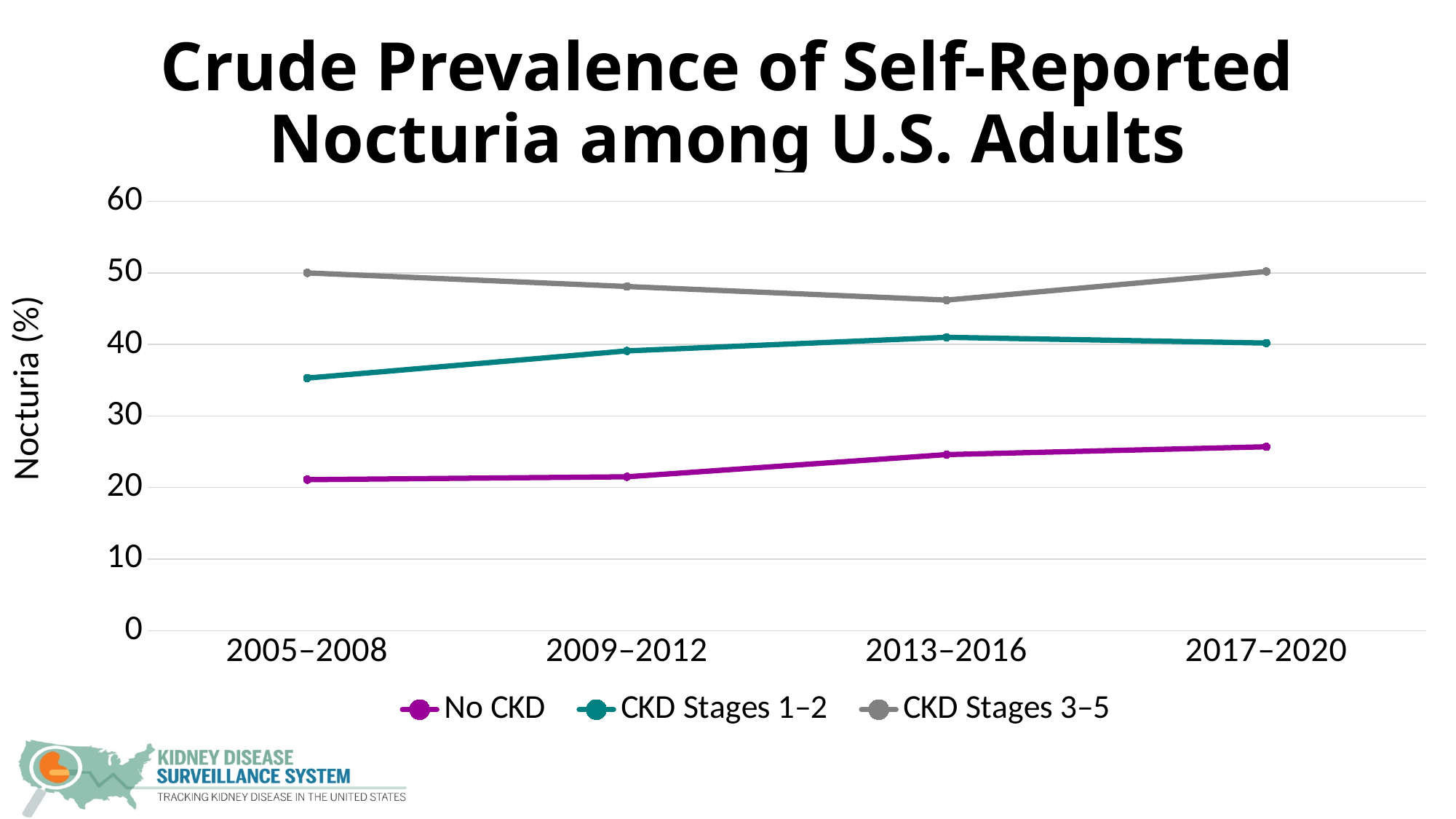
Is the value for CKD Stages 3–5 in 2013–2016 greater or less than 40? greater What kind of chart is shown on the slide? Line chart What is the label on the y axis? Nocturia (%) In which period is the value for CKD Stages 1–2 lowest? 2005–2008 Is the value for CKD Stages 1–2 in 2005–2008 greater or less than 30? greater Does the No CKD line rise or fall from 2005–2008 to 2017–2020? Rises In which period is the value for CKD Stages 3–5 lowest? 2013–2016 How many series does the legend list? 3 Which series has the highest nocturia prevalence across all periods? CKD Stages 3–5 Which is larger in 2017–2020, the value for CKD Stages 3–5 or the value for No CKD? CKD Stages 3–5 How many time periods are shown on the x axis? 4 Is the value for No CKD in 2005–2008 greater or less than 30? less